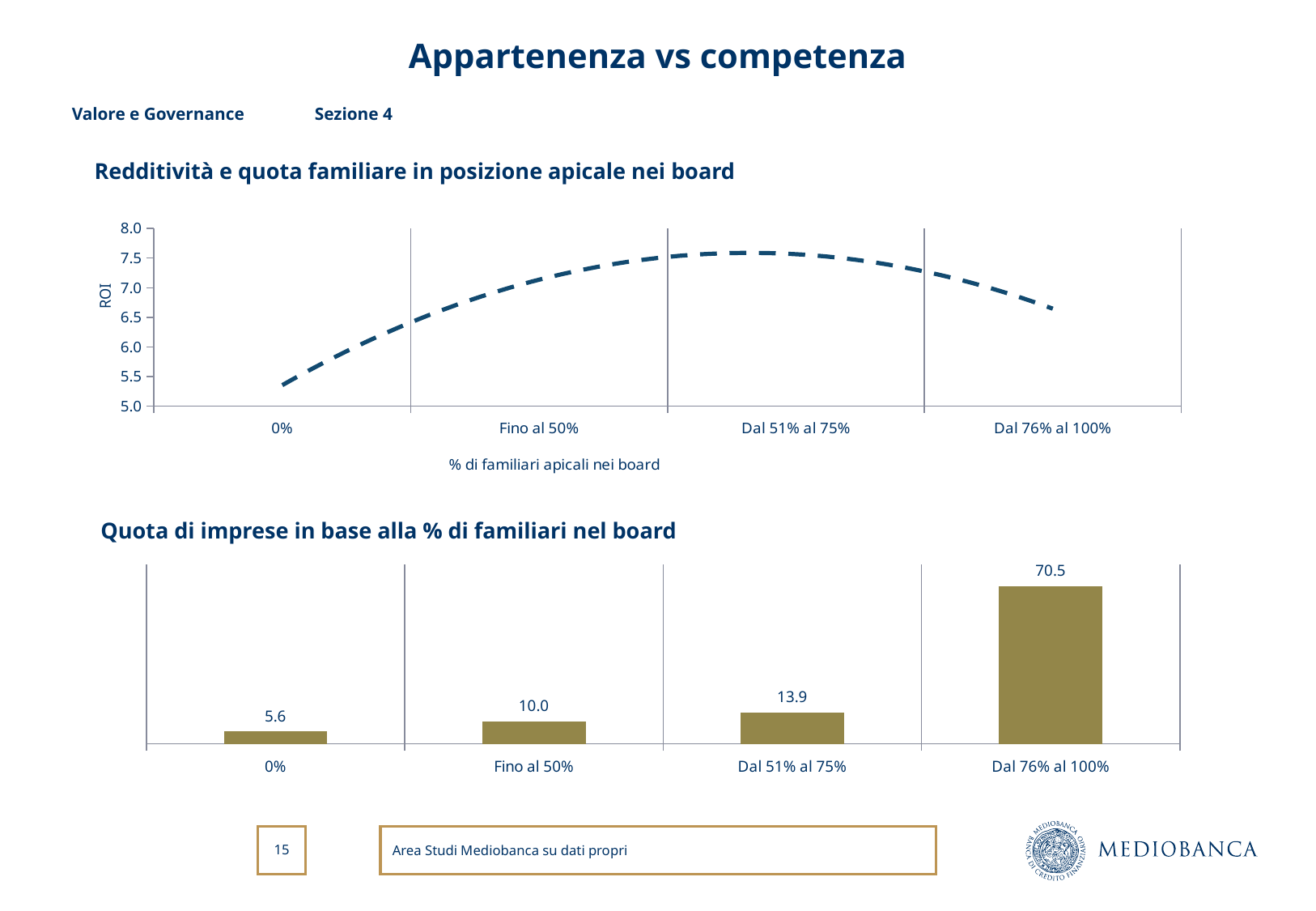
How many categories are shown in the chart 'Quota di imprese in base alla % di familiari nel board'? 4 In the chart 'Quota di imprese in base alla % di familiari nel board', what is the value for 'Dal 76% al 100%'? 70.5 What kind of chart is 'Redditività e quota familiare in posizione apicale nei board'? Line chart In the chart 'Redditività e quota familiare in posizione apicale nei board', is the ROI value for '0%' greater or less than 6.0? less In the chart 'Quota di imprese in base alla % di familiari nel board', which category has the highest value? Dal 76% al 100% In the chart 'Redditività e quota familiare in posizione apicale nei board', is the ROI value for 'Dal 51% al 75%' greater or less than 7.0? greater In the chart 'Quota di imprese in base alla % di familiari nel board', what is the difference between the values for 'Dal 76% al 100%' and 'Dal 51% al 75%'? 56.6 In the chart 'Quota di imprese in base alla % di familiari nel board', what is the value for 'Dal 51% al 75%'? 13.9 In the chart 'Quota di imprese in base alla % di familiari nel board', which category has the lowest value? 0% In the chart 'Quota di imprese in base alla % di familiari nel board', which is larger: the value for 'Fino al 50%' or the value for 'Dal 51% al 75%'? Dal 51% al 75% What kind of chart is 'Quota di imprese in base alla % di familiari nel board'? Bar chart In the chart 'Quota di imprese in base alla % di familiari nel board', what is the value for '0%'? 5.6